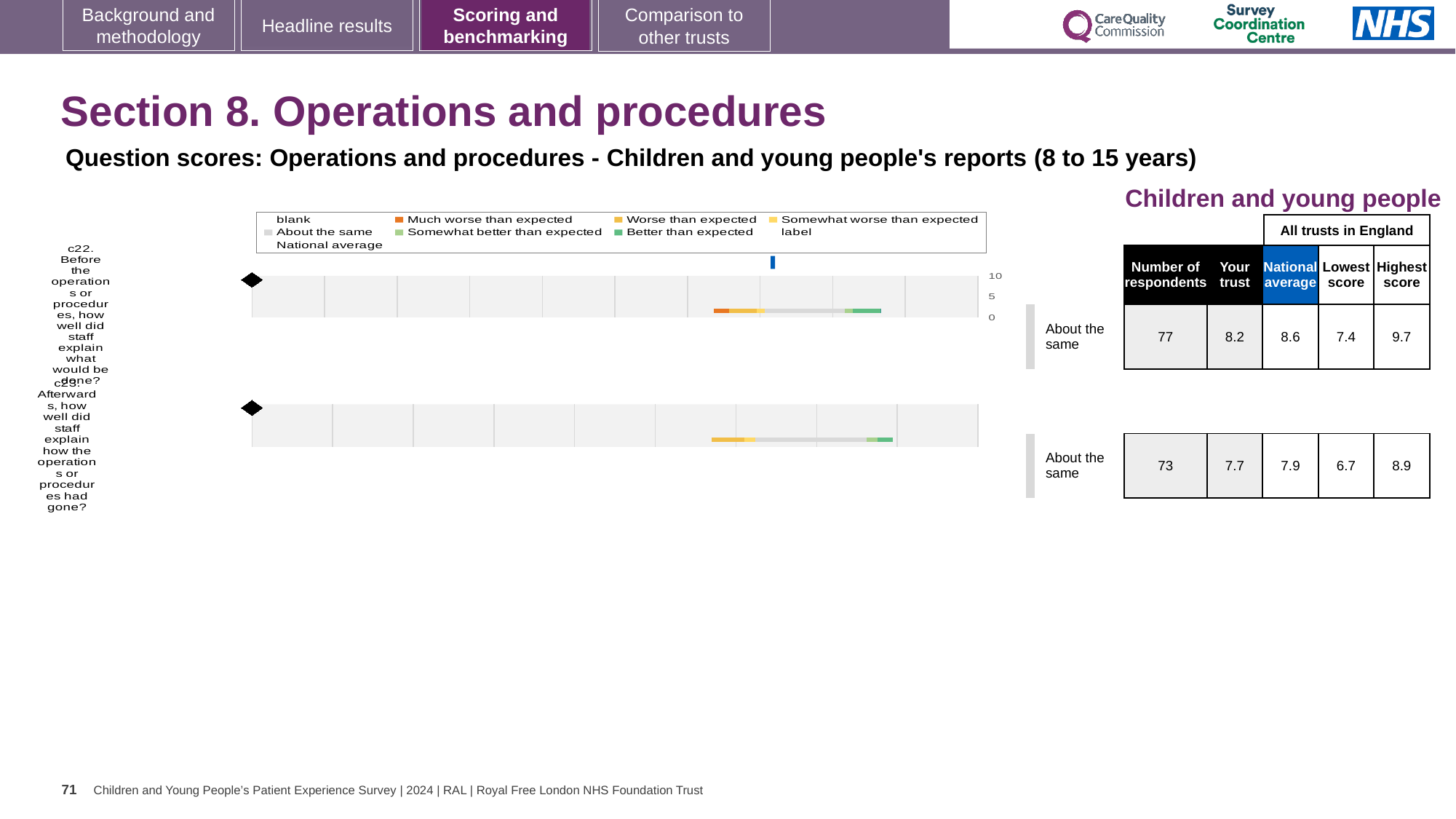
What kind of chart is used to show the question scores for c22 and c23? bar chart Which question has more respondents, c22 or c23? c22 Which legend entry is represented by the orange colour in the chart? Much worse than expected What is the National average score for question c23 (Afterwards, how well did staff explain how the operations or procedures had gone?)? 7.9 How many questions (bars) are plotted in the chart? 2 What is the difference between the Highest score and the Lowest score for question c22? 2.3 For question c23, which is larger: the 'Your trust' score or the National average? National average What is the 'Your trust' score for question c22 (Before the operations or procedures, how well did staff explain what would be done?)? 8.2 How many respondents answered question c22? 77 Is the 'Your trust' score for question c22 greater or less than 5 on the chart's axis? greater What benchmark category is shown for both c22 and c23? About the same What is the Highest score across all trusts in England for question c23? 8.9